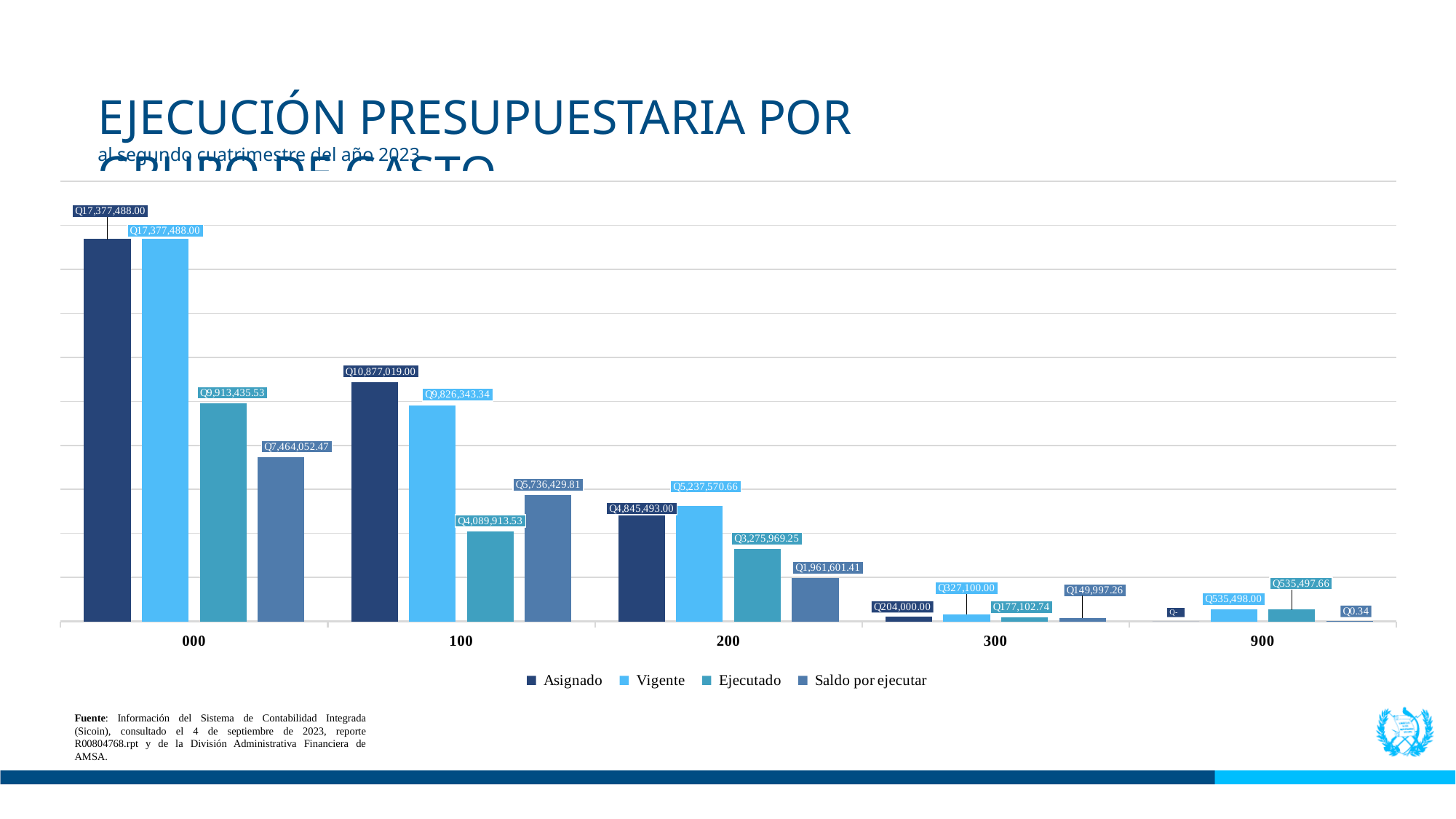
What is the Saldo por ejecutar value for category 900? Q0.34 For category 200, which is larger: the Asignado value or the Vigente value? Vigente What is the Vigente value for category 300? Q327,100.00 Which category has the lowest Vigente value? 300 How many categories are shown on the x axis? 5 What type of chart is shown on the slide? bar chart How many series does the legend list? 4 What is the Ejecutado value for category 000? Q9,913,435.53 What is the difference between the Vigente and Ejecutado values for category 100? Q5,736,429.81 Which category has the highest Asignado value? 000 What is the Asignado value for category 100? Q10,877,019.00 Do the Ejecutado values rise or fall from category 000 to category 300? fall